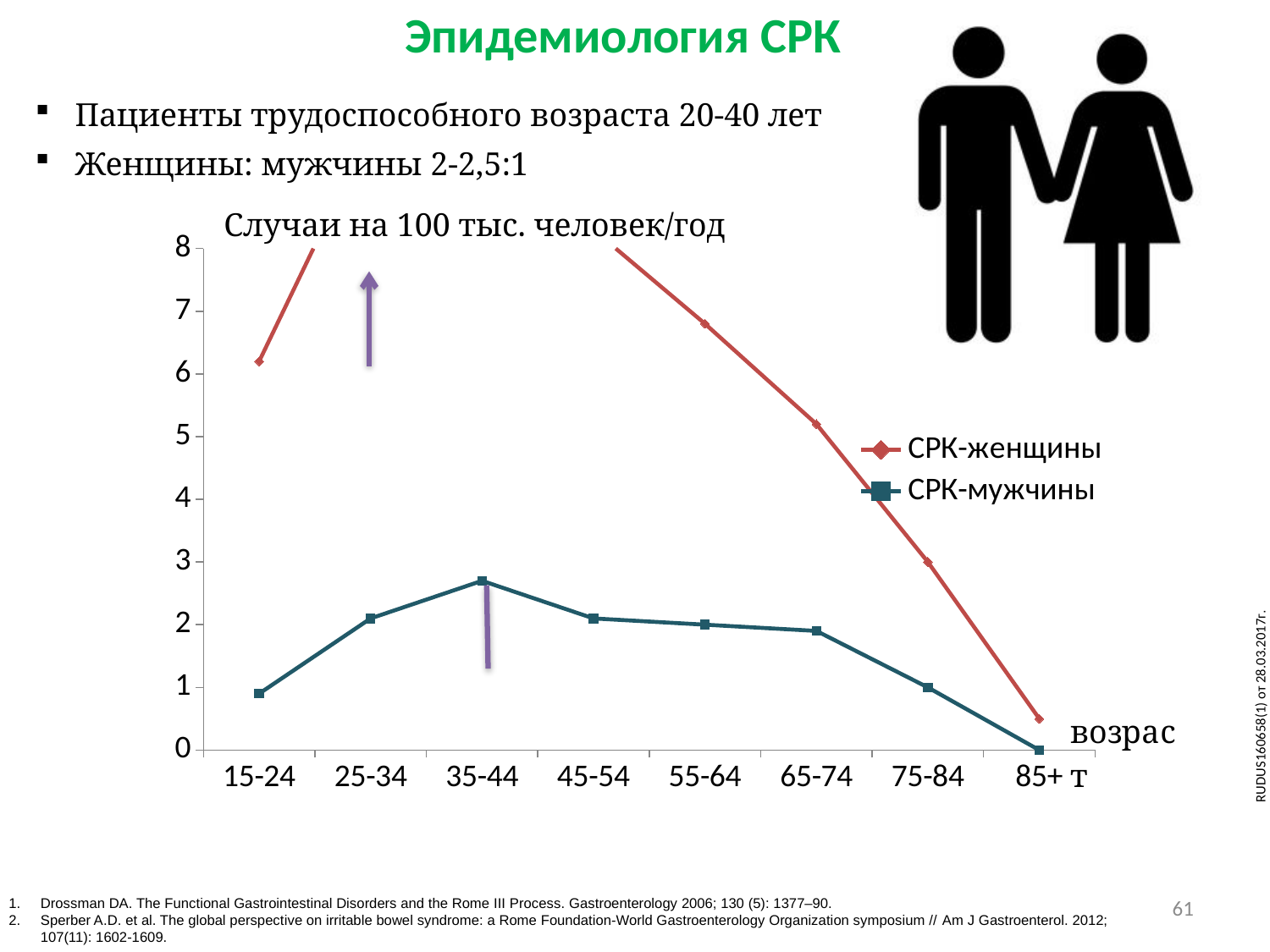
Is the value for СРК-женщины in the 15-24 age group greater or less than 6? greater Which age group has the highest value for СРК-мужчины? 35-44 What is the value for СРК-женщины in the 75-84 age group? 3 How many series does the chart legend list? 2 What kind of chart is shown on the slide? line chart Which age group has the lowest value for СРК-мужчины? 85+ What is the value for СРК-мужчины in the 75-84 age group? 1 What is the value for СРК-мужчины in the 85+ age group? 0 In the 65-74 age group, which series has the larger value, СРК-женщины or СРК-мужчины? СРК-женщины How many age groups are shown on the x axis of the chart? 8 What are the two series named in the chart legend? СРК-женщины and СРК-мужчины